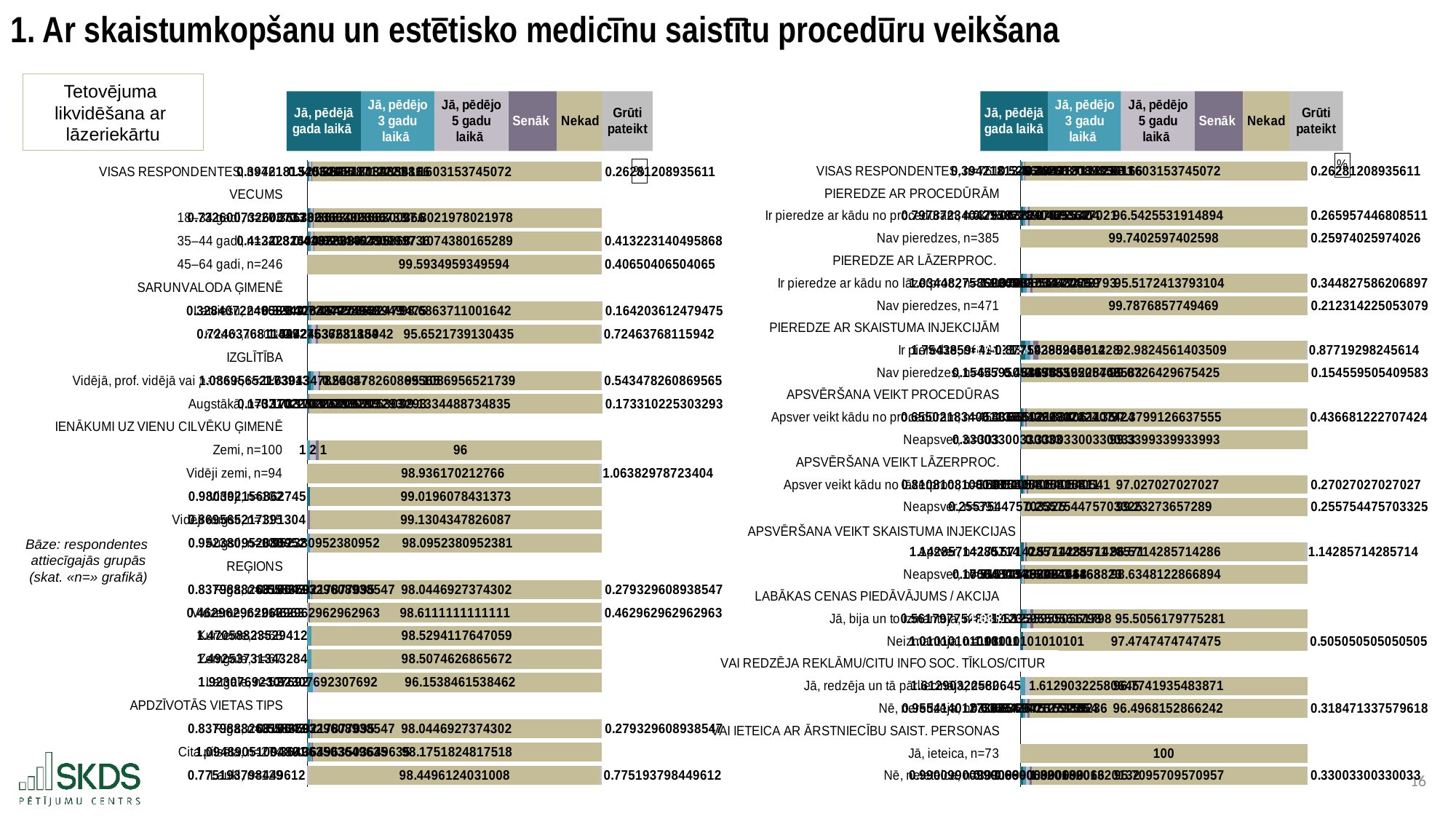
What kind of chart is used on this slide for 'Tetovējuma likvidēšana ar lāzeriekārtu'? Bar chart In the right chart, what is the 'Grūti pateikt' value for 'Nav pieredzes, n=471'? 0.212314225053079 What is the first legend entry of the left chart? Jā, pēdējā gada laikā In the right chart, what is the 'Nekad' value for 'Jā, ieteica, n=73'? 100 In the left chart, what is the 'Nekad' value for 'Zemi, n=100'? 96 In the left chart, what is the 'Nekad' value for 'Vidēji zemi, n=94'? 98.936170212766 In the left chart, what is the 'Grūti pateikt' value for '45–64 gadi, n=246'? 0.40650406504065 In the right chart, what is the 'Nekad' value for 'Nav pieredzes, n=385'? 99.7402597402598 In the left chart, what is the 'Nekad' value for '45–64 gadi, n=246'? 99.5934959349594 How many series does the legend of the left chart list? 6 In the left chart, what is the 'Grūti pateikt' value for 'Vidēji zemi, n=94'? 1.06382978723404 In the left chart, which has the larger 'Nekad' value: 'Zemi, n=100' or 'Vidēji zemi, n=94'? Vidēji zemi, n=94